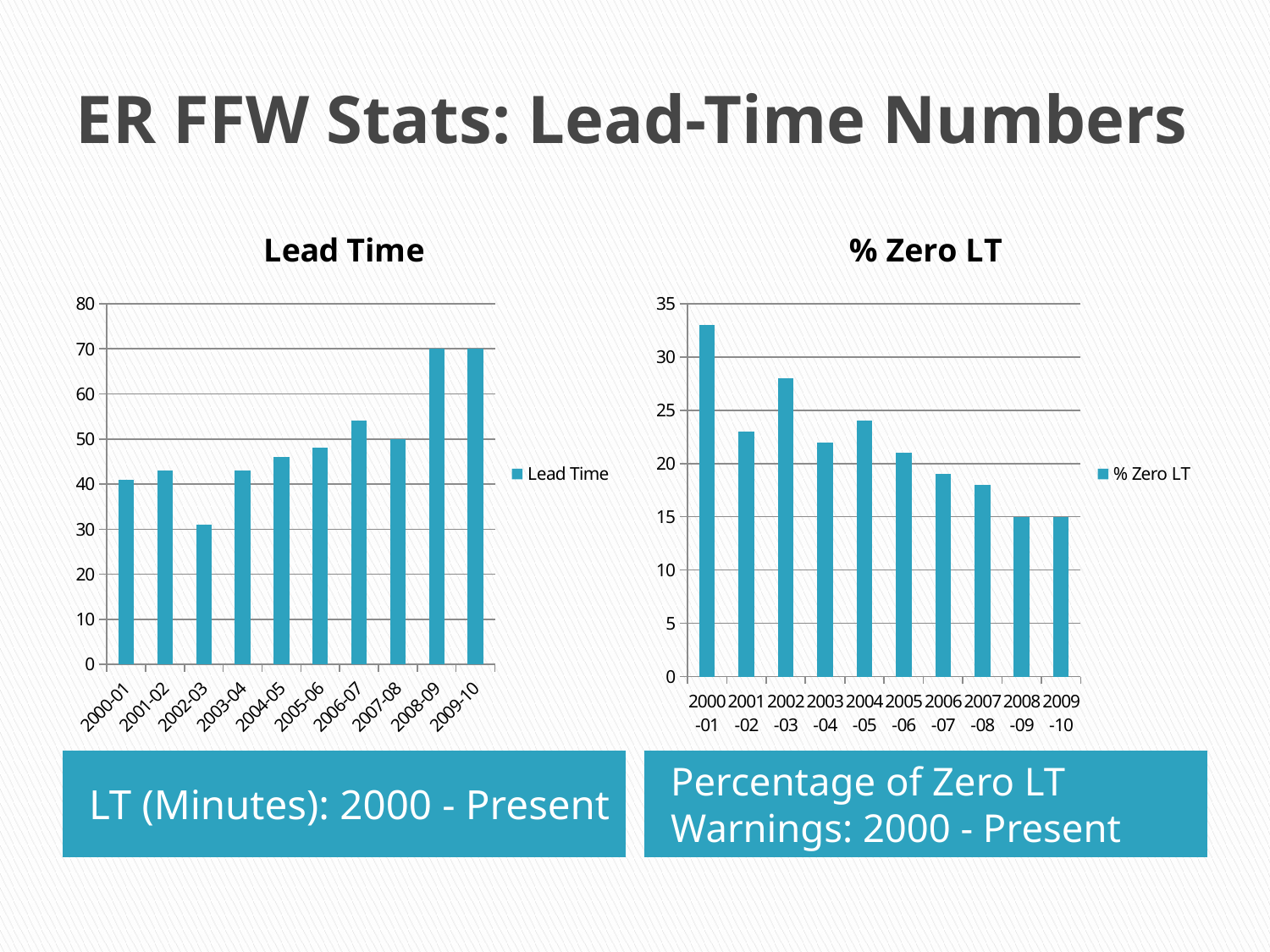
In the % Zero LT chart, what is the value for 2009-10? 15 In the Lead Time chart, is the value for 2002-03 greater or less than 40? less In the % Zero LT chart, is the value for 2000-01 greater or less than 30? greater What kind of chart is the Lead Time chart? bar chart In the Lead Time chart, what is the value for 2007-08? 50 In the % Zero LT chart, which category has the highest value? 2000-01 In the Lead Time chart, which category has the lowest value? 2002-03 In the % Zero LT chart, which is larger, the value for 2002-03 or the value for 2007-08? 2002-03 In the Lead Time chart, which is larger, the value for 2006-07 or the value for 2002-03? 2006-07 How many categories are shown on the x axis of the % Zero LT chart? 10 In the Lead Time chart, what is the value for 2008-09? 70 In the % Zero LT chart, do the values generally rise or fall from 2000-01 to 2009-10? fall